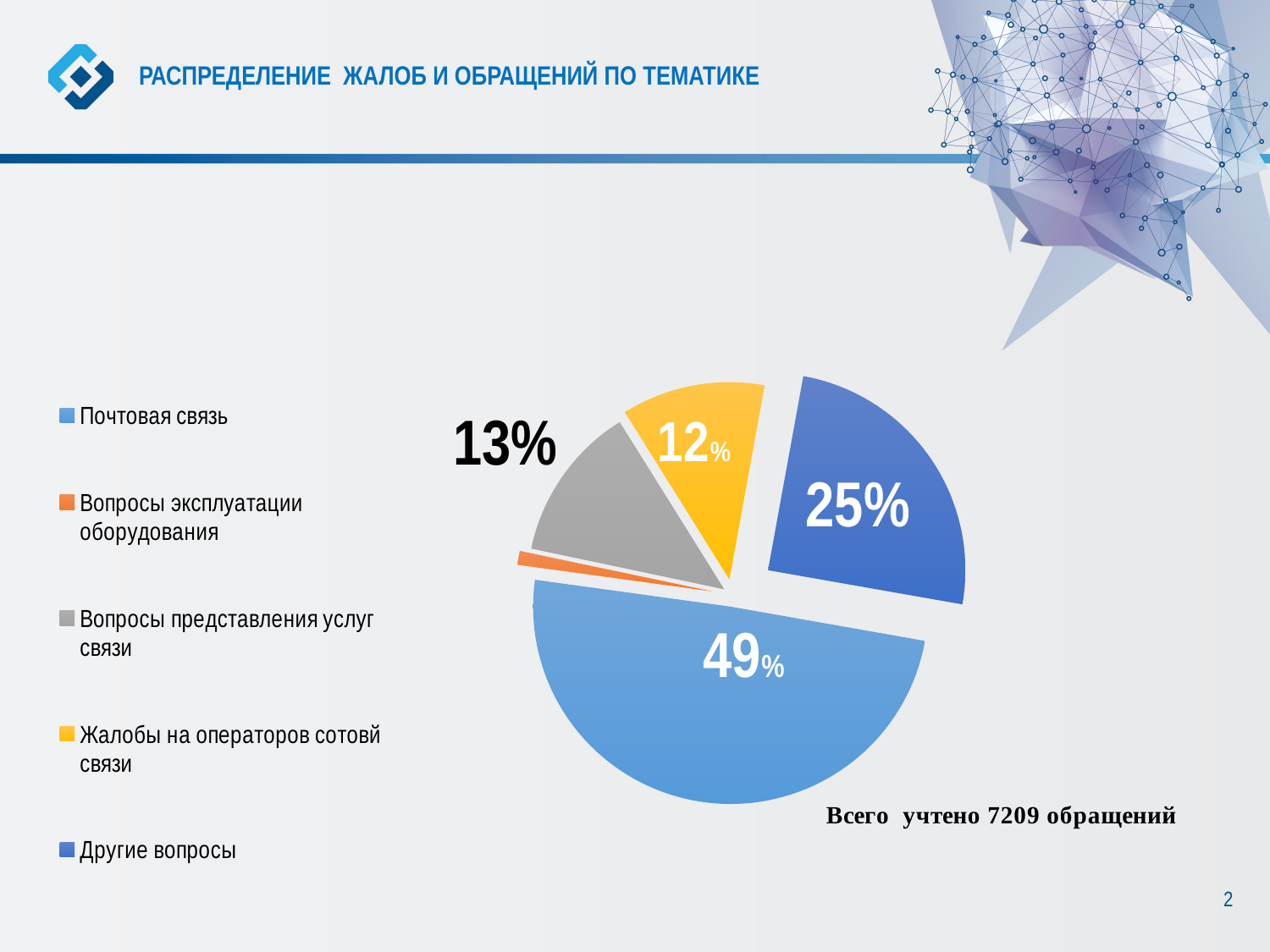
Which category has the largest slice of the pie? Почтовая связь What is the title of the slide containing the pie chart? РАСПРЕДЕЛЕНИЕ ЖАЛОБ И ОБРАЩЕНИЙ ПО ТЕМАТИКЕ How many categories does the legend of the pie chart list? 5 What share of the pie does "Другие вопросы" have? 25% What type of chart is shown on the slide? Pie chart According to the note below the pie chart, how many appeals were counted in total? 7209 Which is larger: the slice for "Другие вопросы" or the slice for "Вопросы представления услуг связи"? Другие вопросы What share of the pie does "Почтовая связь" have? 49% What share of the pie does "Жалобы на операторов сотовй связи" have? 12% What is the difference in percentage points between the "Почтовая связь" slice and the "Другие вопросы" slice? 24% What share of the pie does "Вопросы представления услуг связи" have? 13% Which category has the smallest slice of the pie? Вопросы эксплуатации оборудования